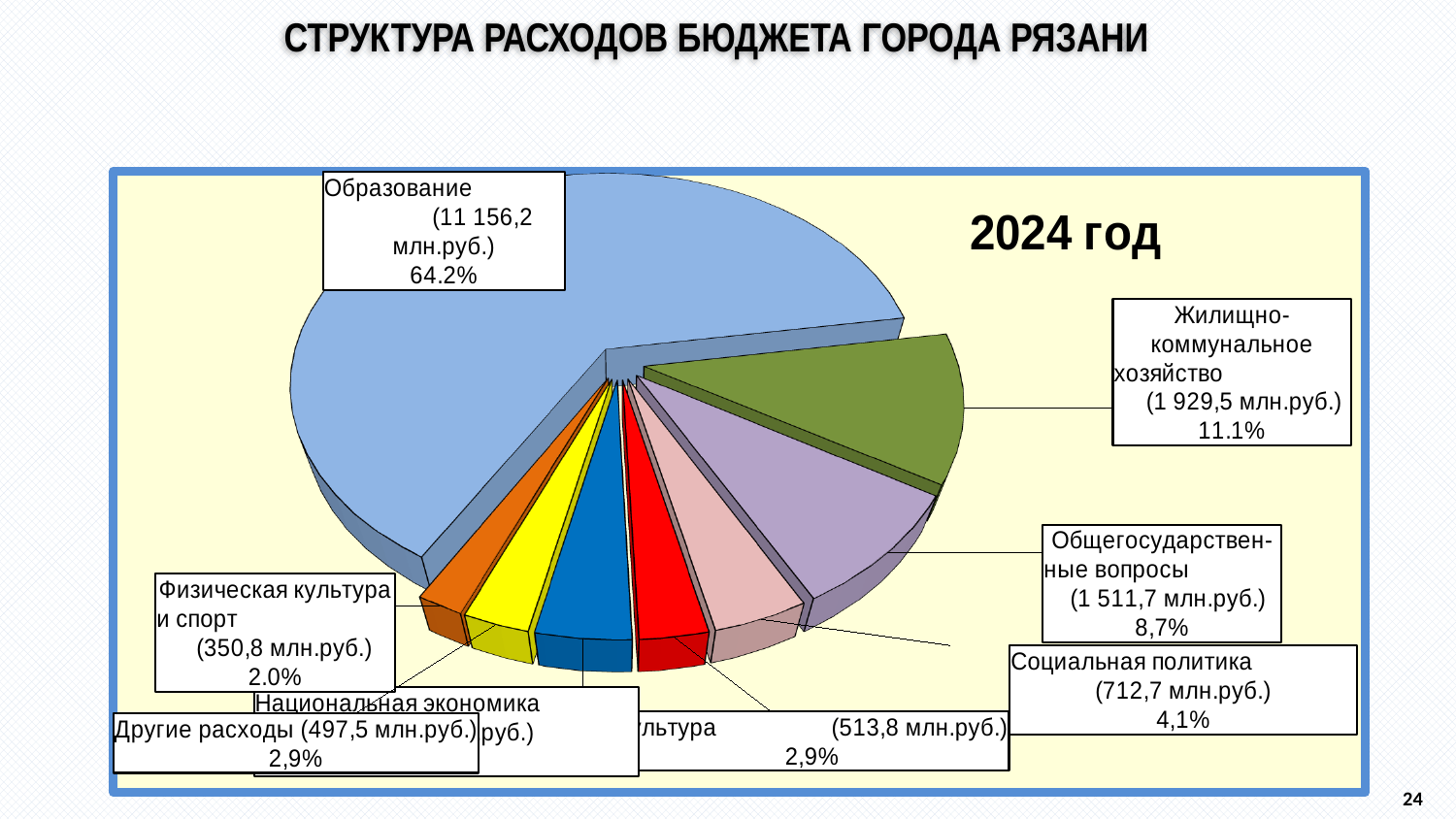
What is the amount for Общегосударственные вопросы? 1 511,7 млн.руб. What is the difference in percentage points between the shares of Жилищно-коммунальное хозяйство and Общегосударственные вопросы? 2.4 What share of the budget expenditures goes to Образование? 64.2% Which year does the chart show data for? 2024 год Which category has the largest share of the budget expenditures? Образование What share of expenditures is Жилищно-коммунальное хозяйство? 11.1% What is the amount in млн.руб. for Образование? 11 156,2 млн.руб. What is the amount for Другие расходы? 497,5 млн.руб. Which is larger: the share for Жилищно-коммунальное хозяйство or for Общегосударственные вопросы? Жилищно-коммунальное хозяйство What is the amount for Физическая культура и спорт? 350,8 млн.руб. What type of chart is shown on the slide? pie chart What share of expenditures is Социальная политика? 4,1%